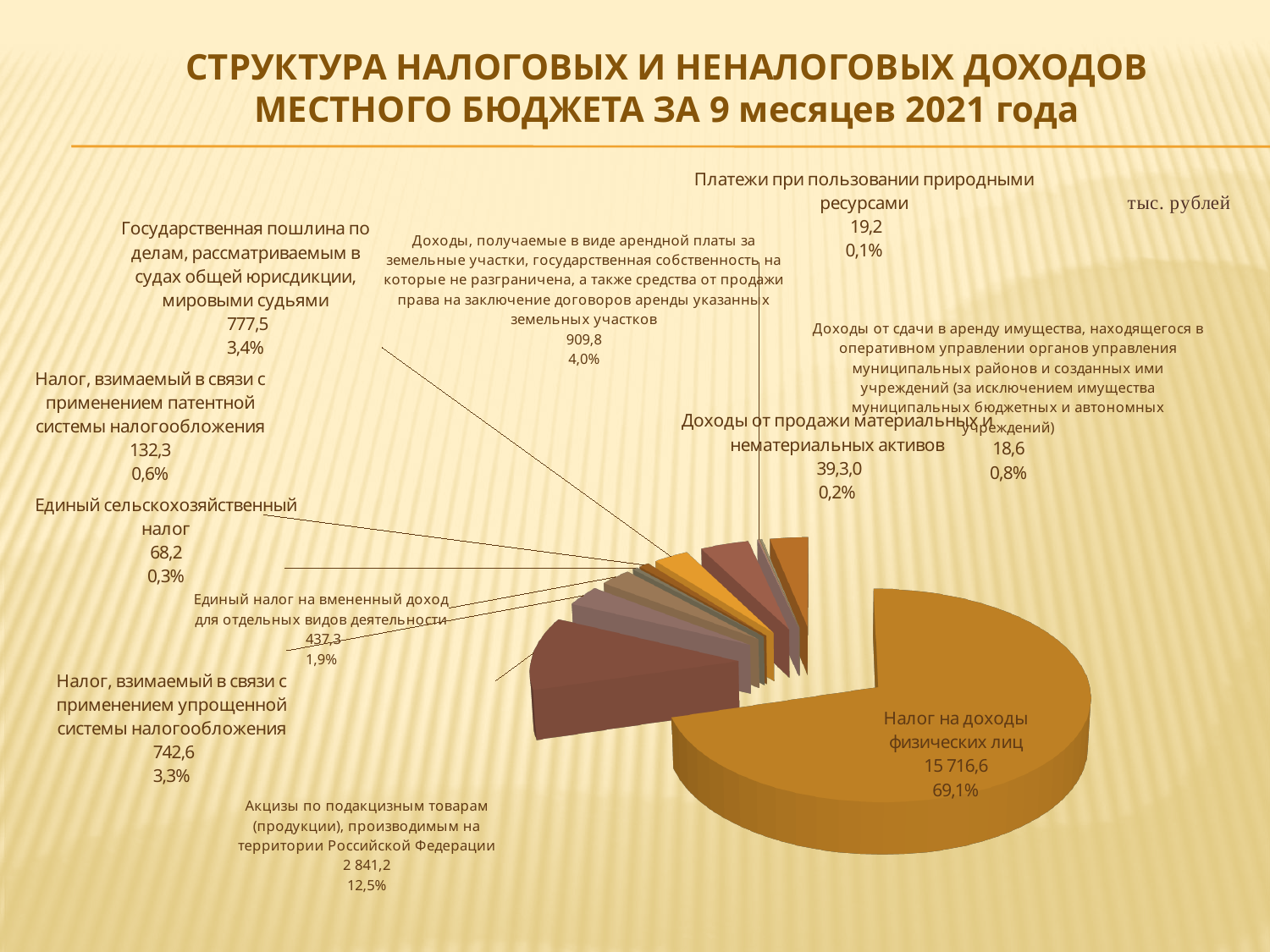
Which is larger: the value for Акцизы по подакцизным товарам or the value for Государственная пошлина по делам, рассматриваемым в судах общей юрисдикции, мировыми судьями? Акцизы по подакцизным товарам How many categories (slices) are labelled on the pie chart? 11 What percentage is shown for Единый налог на вмененный доход для отдельных видов деятельности? 1,9% Which category has the largest share of the pie? Налог на доходы физических лиц In what units are the values on the chart given, according to the note in the top right? тыс. рублей Which category has the smallest percentage share shown on the chart? Платежи при пользовании природными ресурсами What kind of chart is shown on the slide? Pie chart What is the value for Платежи при пользовании природными ресурсами? 19,2 What share of the pie does Налог на доходы физических лиц represent? 69,1% What is the difference between the value for Государственная пошлина (777,5) and the value for Налог, взимаемый в связи с применением упрощенной системы налогообложения (742,6)? 34,9 What is the value for Акцизы по подакцизным товарам (продукции), производимым на территории Российской Федерации? 2 841,2 What is the value for Налог на доходы физических лиц? 15 716,6